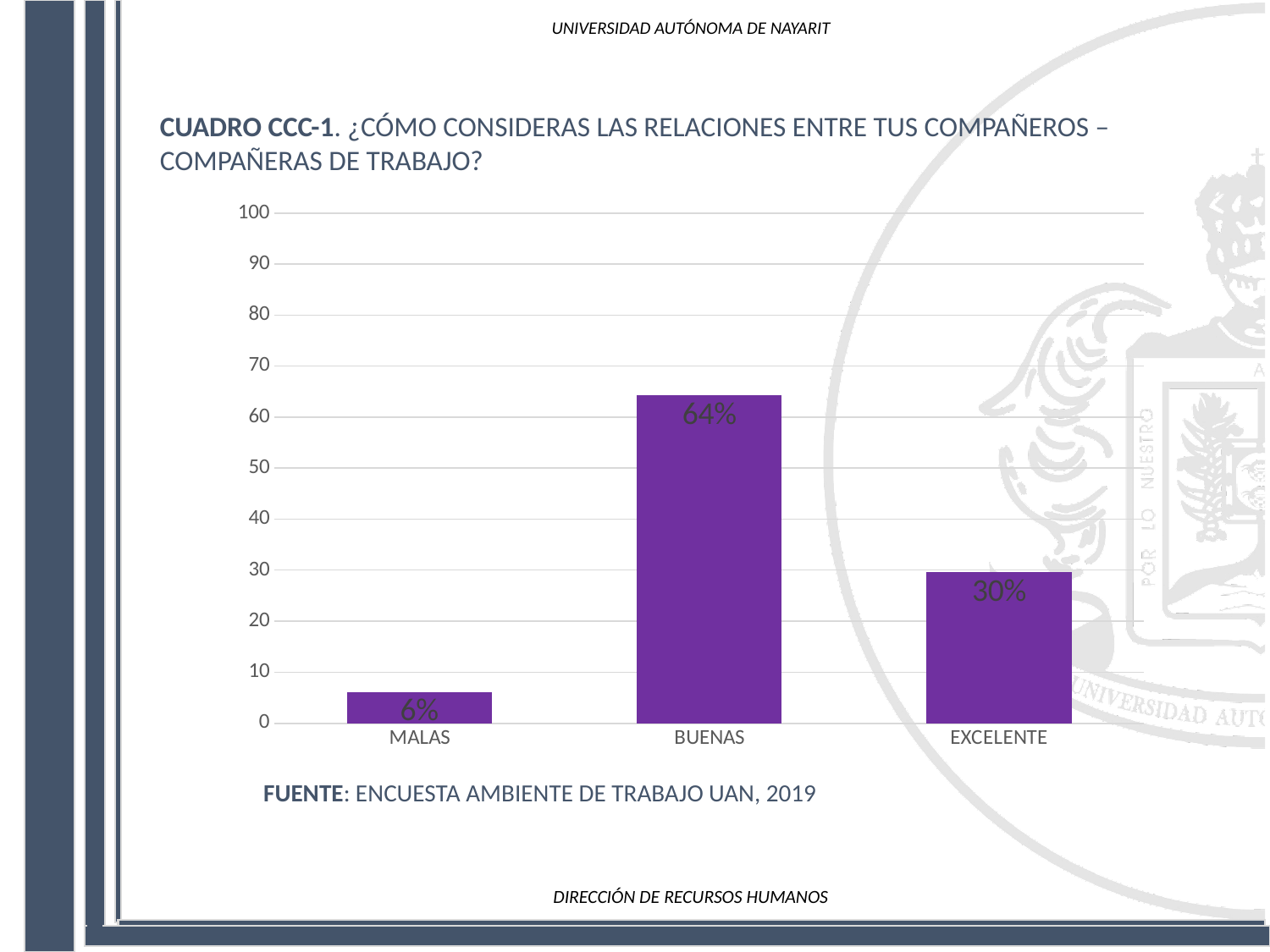
Which is larger, the value for EXCELENTE or the value for MALAS? EXCELENTE Which category has the highest value? BUENAS Which category has the lowest value? MALAS What is the value for MALAS? 6% What kind of chart is shown on the slide? bar chart What is the value for EXCELENTE? 30% What is the difference between the values for EXCELENTE and MALAS? 24% What is the difference between the values for BUENAS and EXCELENTE? 34% Is the value for BUENAS greater or less than 50? greater How many categories are shown on the x axis? 3 What source is cited below the chart? ENCUESTA AMBIENTE DE TRABAJO UAN, 2019 What is the value for BUENAS? 64%